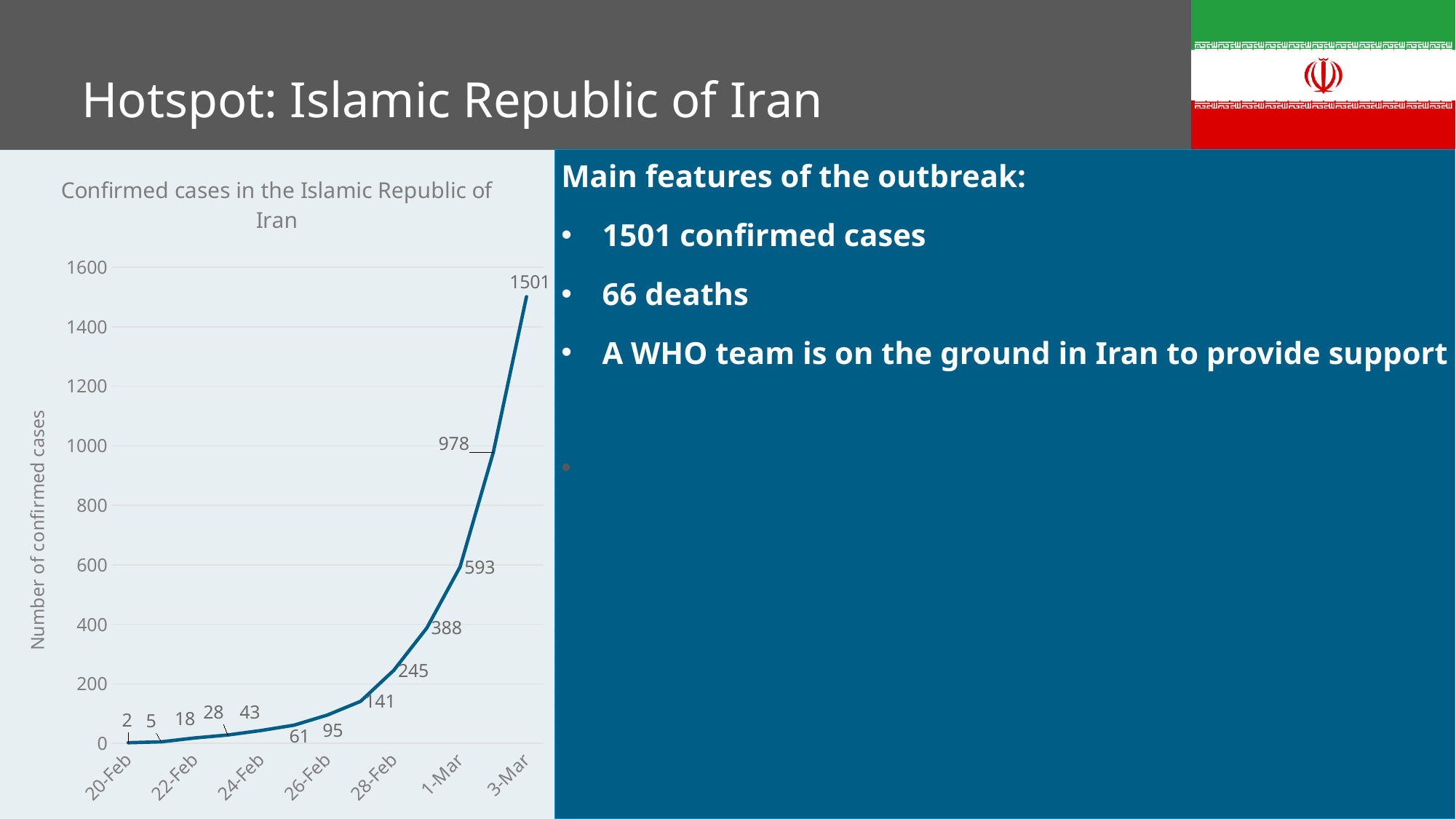
What is the label of the vertical axis of the chart? Number of confirmed cases What is the number of confirmed cases on 28-Feb? 245 Do the confirmed cases rise or fall from 20-Feb to 3-Mar? rise How many data points are plotted on the line? 13 What is the highest value labelled on the chart? 1501 What is the difference between the values labelled 1501 and 978? 523 What type of chart is shown on the slide? line chart What is the number of confirmed cases on 1-Mar? 593 What is the lowest value labelled on the chart? 2 What is the title of the chart? Confirmed cases in the Islamic Republic of Iran What is the number of confirmed cases on 3-Mar? 1501 Is the value for 1-Mar greater or less than 400? greater